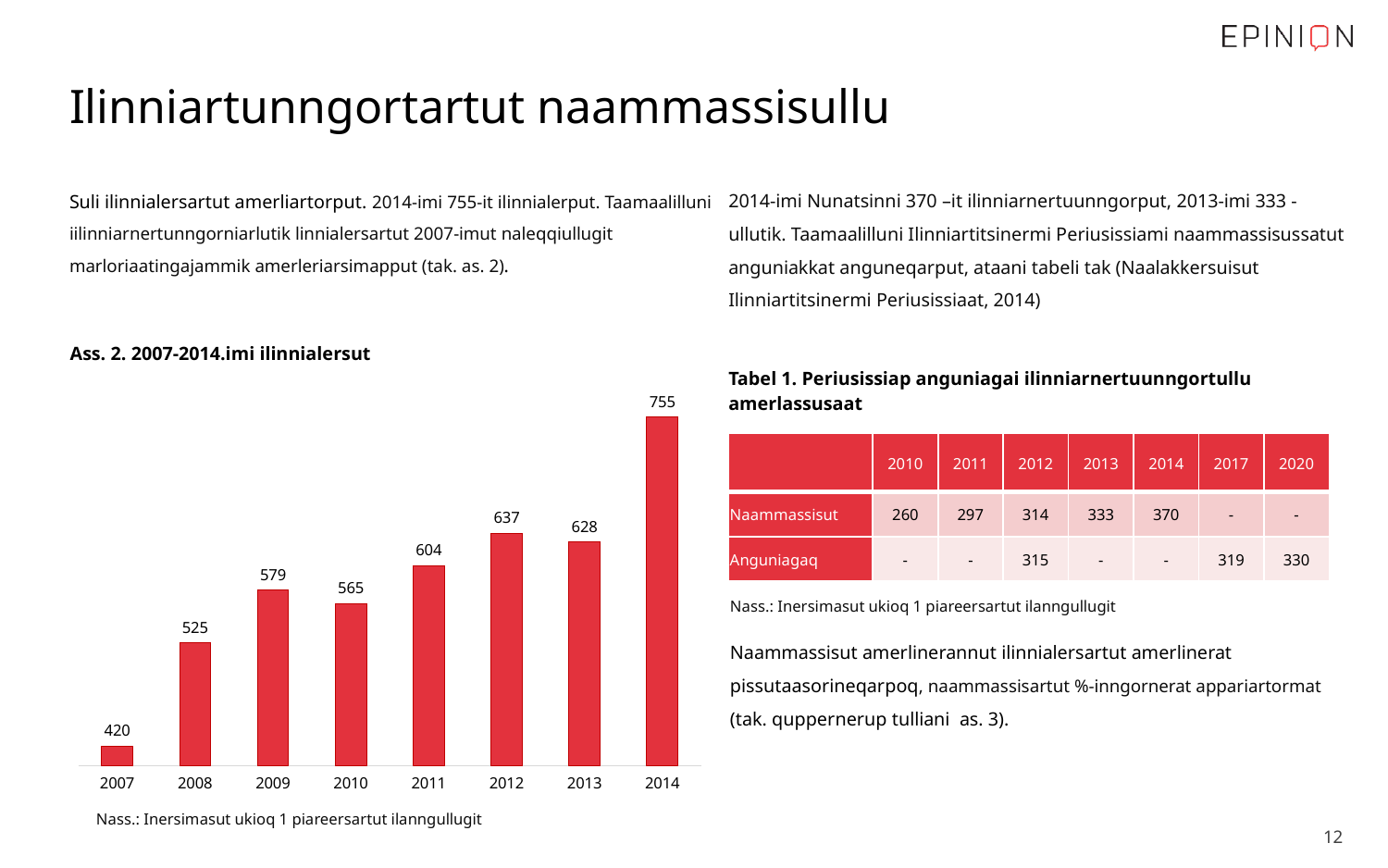
What is the value for 2011 in the chart? 604 What kind of chart is shown on the slide? bar chart Does the value rise or fall from 2012 to 2013 in the chart? fall What is the title of the chart on the slide? Ass. 2. 2007-2014.imi ilinnialersut What is the value for 2013 in the chart? 628 What is the value for 2007 in the chart 'Ass. 2. 2007-2014.imi ilinnialersut'? 420 How many years are shown in the chart? 8 What is the difference between the values for 2012 and 2013 in the chart? 9 What is the difference between the values for 2014 and 2007 in the chart? 335 Which is larger in the chart, the value for 2009 or the value for 2010? 2009 Which year has the lowest value in the chart? 2007 Which year has the highest value in the chart? 2014